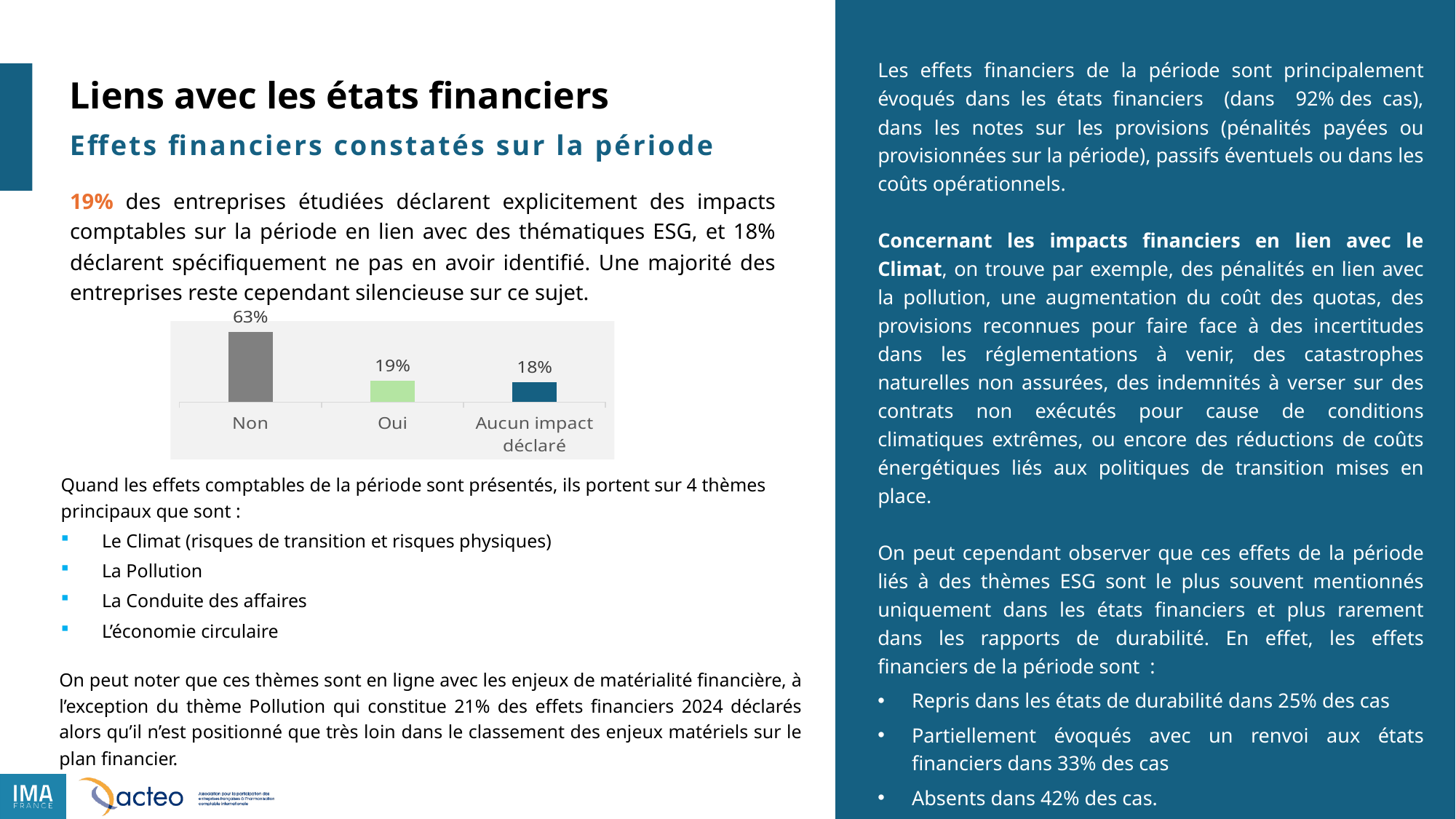
How many categories are shown in the chart? 3 Which category has the lowest value in the chart? Aucun impact déclaré What is the difference between the values for 'Non' and 'Oui'? 44% What kind of chart is shown on the slide? Bar chart What colour is the bar for the 'Oui' category? Light green Which category has the highest value in the chart? Non What is the value for the 'Non' category in the chart? 63% Which is larger, the value for 'Non' or the value for 'Aucun impact déclaré'? Non What is the value for the 'Oui' category in the chart? 19% What is the value for the 'Aucun impact déclaré' category in the chart? 18% What is the difference between the values for 'Oui' and 'Aucun impact déclaré'? 1% What colour is the bar for the 'Non' category? Grey